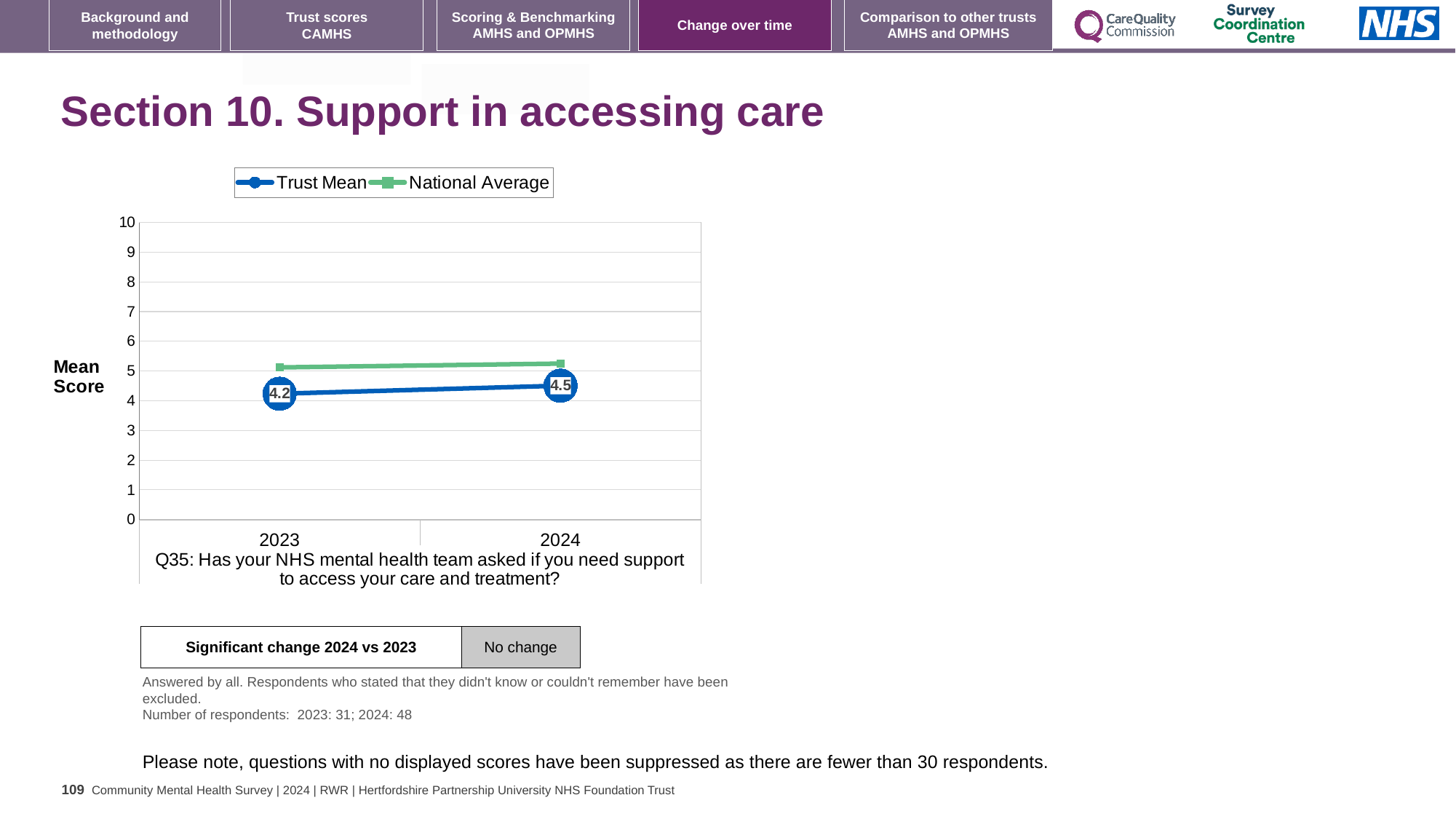
Is the National Average value for 2024 greater or less than 6? less In which year is the Trust Mean score higher, 2023 or 2024? 2024 In 2023, which series has the higher value, Trust Mean or National Average? National Average Is the Trust Mean value for 2023 greater or less than 5? less What is the difference between the Trust Mean scores for 2024 and 2023? 0.3 Does the Trust Mean rise or fall from 2023 to 2024? rise What is the Trust Mean score for 2024? 4.5 What is the label of the y axis? Mean Score How many series does the legend list? 2 What is the Trust Mean score for 2023? 4.2 How many years are shown on the x axis? 2 What kind of chart is shown on the slide? line chart